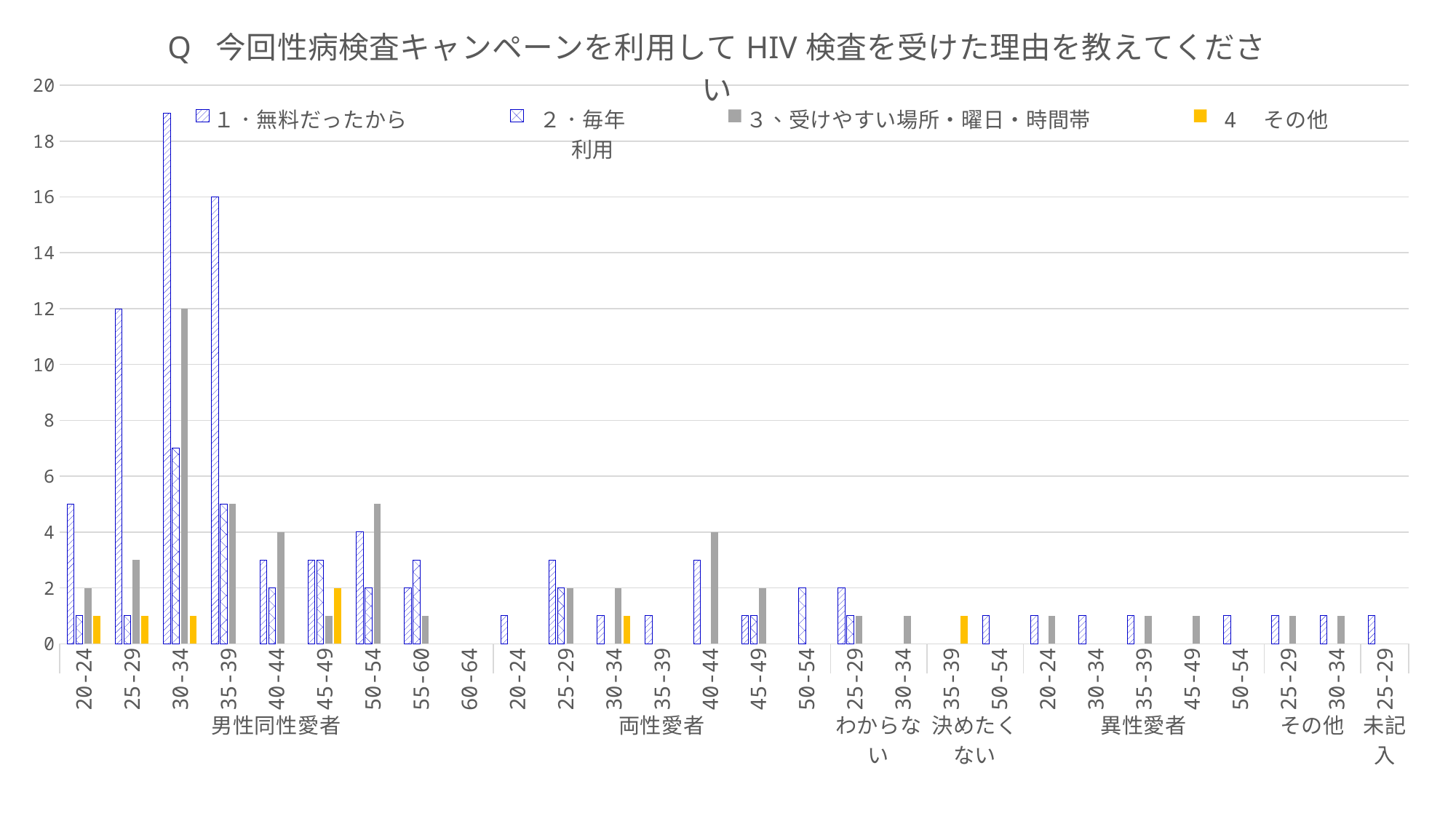
Which group and series has the highest bar in the chart? 30-34 under 男性同性愛者, 1・無料だったから What is the value of series 3、受けやすい場所・曜日・時間帯 for the 40-44 group under 両性愛者? 4 What is the value of series 1・無料だったから for the 25-29 group under 男性同性愛者? 12 What is the value of series 1・無料だったから for the 35-39 group under 男性同性愛者? 16 How many age groups are shown under the 男性同性愛者 category? 9 For series 1・無料だったから under 男性同性愛者, which is larger: the 25-29 group or the 35-39 group? 35-39 What kind of chart is shown on the slide? bar chart What is the value of series 3、受けやすい場所・曜日・時間帯 for the 30-34 group under 男性同性愛者? 12 Is the value of series 1・無料だったから for the 30-34 group under 男性同性愛者 greater or less than 18? greater What is the difference between the 35-39 and 25-29 values of series 1・無料だったから under 男性同性愛者? 4 How many series does the legend list? 4 Is the value of series 2・毎年利用 for the 30-34 group under 男性同性愛者 greater or less than 6? greater